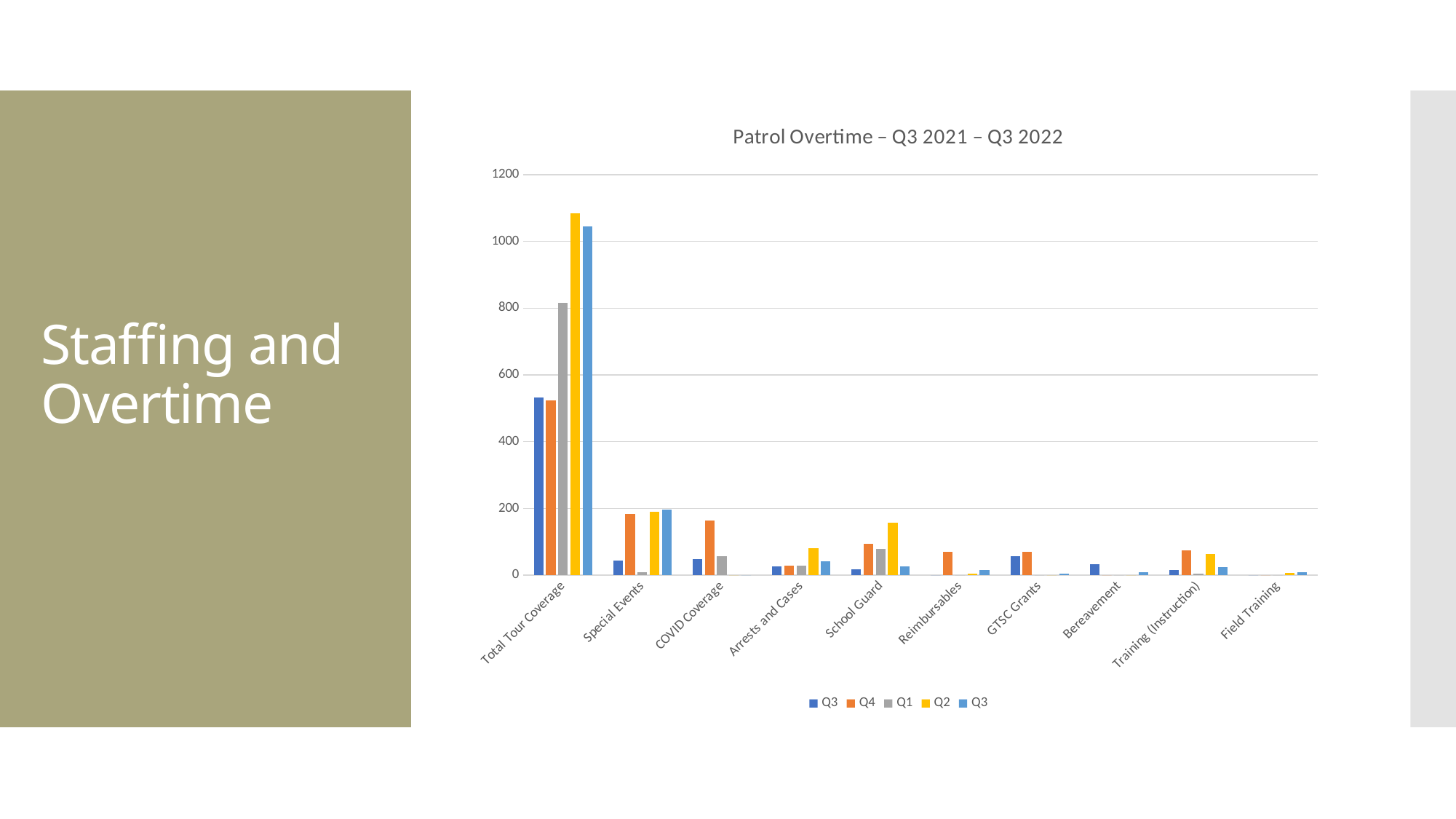
Within Total Tour Coverage, which series has the highest value? Q2 How many categories are shown on the x axis of the chart? 10 What kind of chart is shown on the slide? Bar chart Which category has the lowest overtime values in the chart? Field Training How many series does the chart's legend list? 5 Is the Q1 value for Total Tour Coverage greater or less than 600? greater What is the title of the chart? Patrol Overtime – Q3 2021 – Q3 2022 Which category has the highest overtime values in the chart? Total Tour Coverage For Total Tour Coverage, which is larger: the Q2 value or the Q1 value? Q2 Is the Q2 value for Total Tour Coverage greater or less than 1000? greater Is the Q4 value for Special Events greater or less than 200? less For Special Events, which is larger: the Q4 value or the Q1 value? Q4